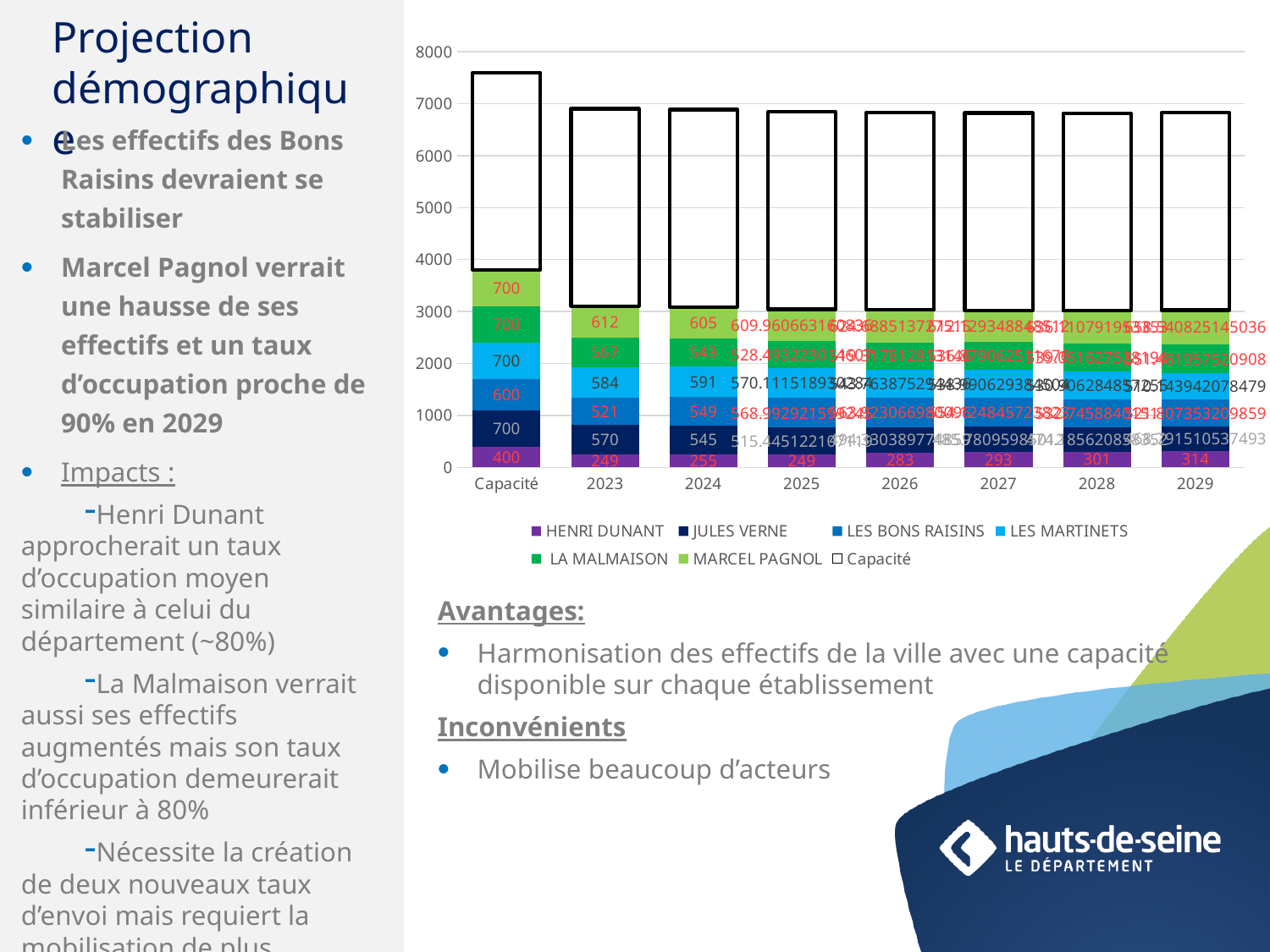
How many categories are shown along the x axis of the chart? 8 What is the difference between the HENRI DUNANT value in 2029 and in 2023? 65 What is the value for LES BONS RAISINS in 2024? 549 What kind of chart is shown on the slide? bar chart What is the value for LES MARTINETS in 2024? 591 Among the years 2023 to 2029, in which year is the HENRI DUNANT value highest? 2029 Do the HENRI DUNANT values rise or fall from 2025 to 2029? rise What is the value for MARCEL PAGNOL in 2023? 612 Which is larger, the JULES VERNE value in 2023 or in 2024? 2023 How many series does the chart legend list? 7 What is the value for HENRI DUNANT in the Capacité category? 400 What is the value for HENRI DUNANT in 2029? 314